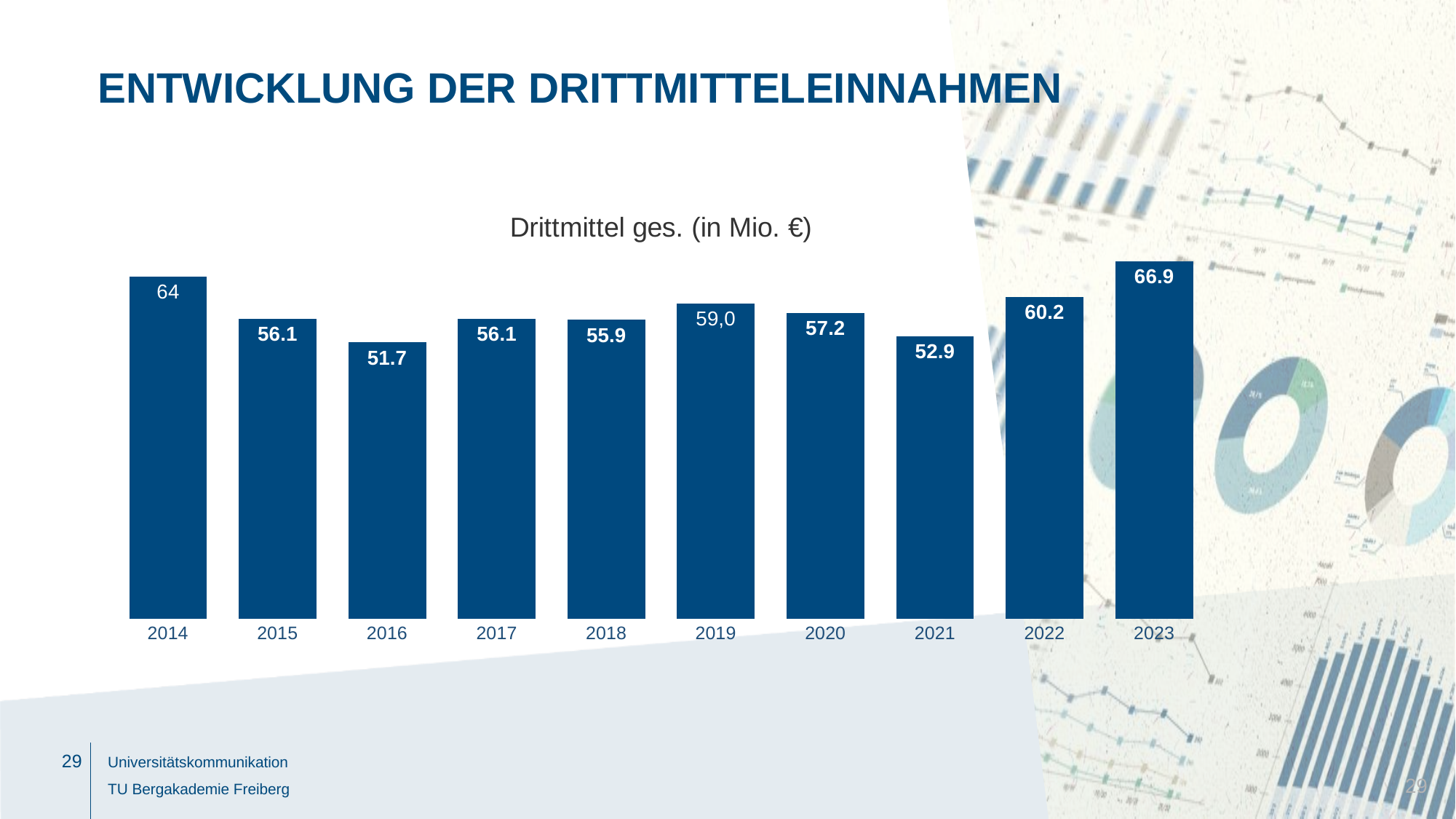
What is the difference between the values for 2023 and 2022? 6.7 What is the title of the chart? Drittmittel ges. (in Mio. €) What is the value for 2014 in the chart? 64 What is the value for 2022 in the chart? 60.2 What is the value for 2019 in the chart? 59,0 Which is larger, the value for 2020 or the value for 2021? 2020 What is the value for 2016 in the chart? 51.7 How many years are shown in the chart? 10 Which year has the lowest value in the chart? 2016 Which year has the highest value in the chart? 2023 What is the difference between the values for 2014 and 2015? 7.9 What kind of chart is shown on the slide? bar chart